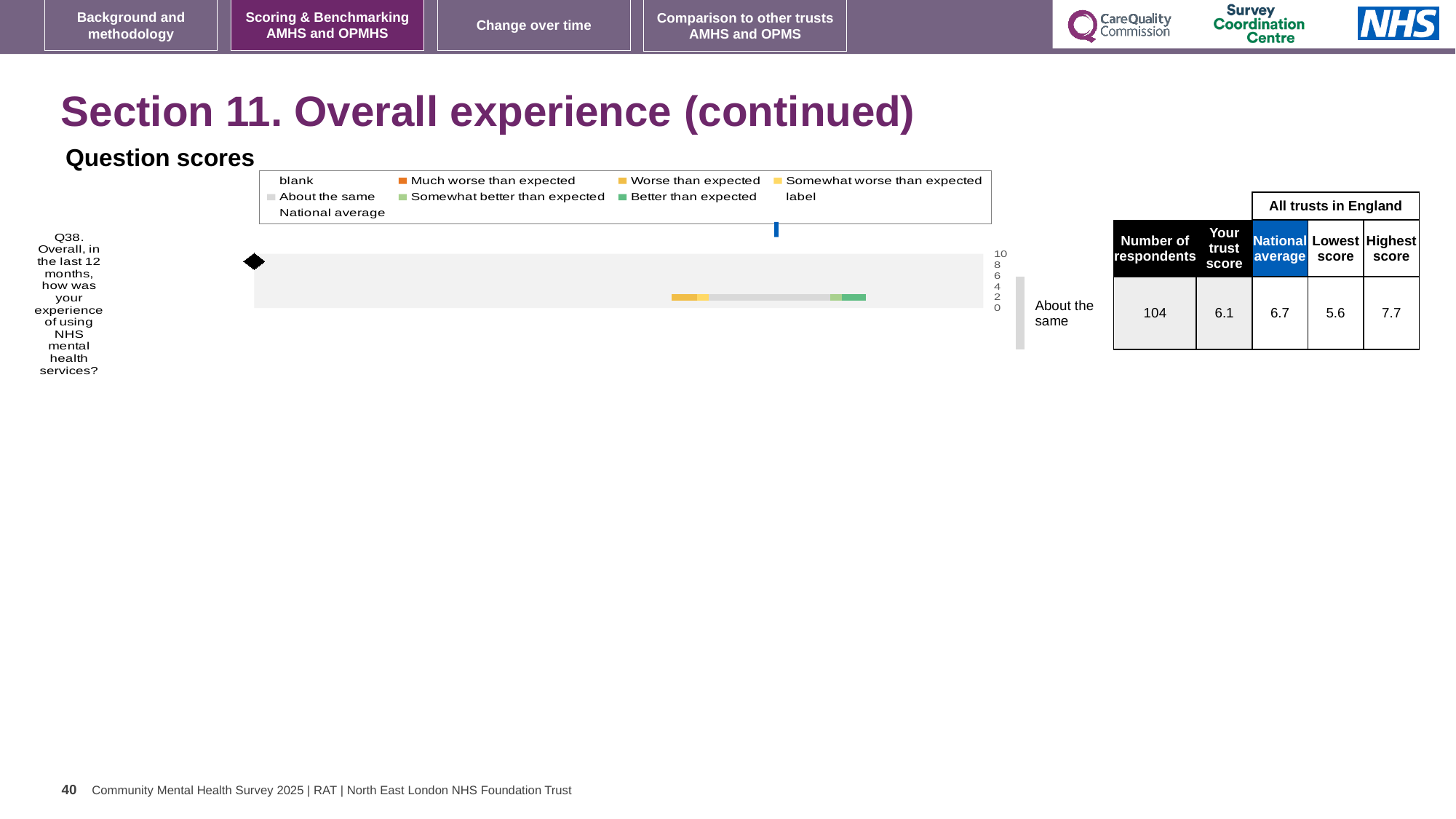
Which benchmark category is the trust's Q38 score placed in? About the same How many respondents answered Q38? 104 Which is larger for Q38, the trust score or the national average? national average What is the trust score for Q38 shown alongside the chart? 6.1 How many questions are plotted in the Question scores chart? 1 What is the difference between the national average and the trust score for Q38? 0.6 What is the highest score among all trusts in England for Q38? 7.7 What is the lowest score among all trusts in England for Q38? 5.6 What is the difference between the highest and lowest trust scores for Q38? 2.1 What kind of chart is shown under 'Question scores'? bar chart What is the national average score for Q38? 6.7 What colour does the legend use for 'Better than expected'? green